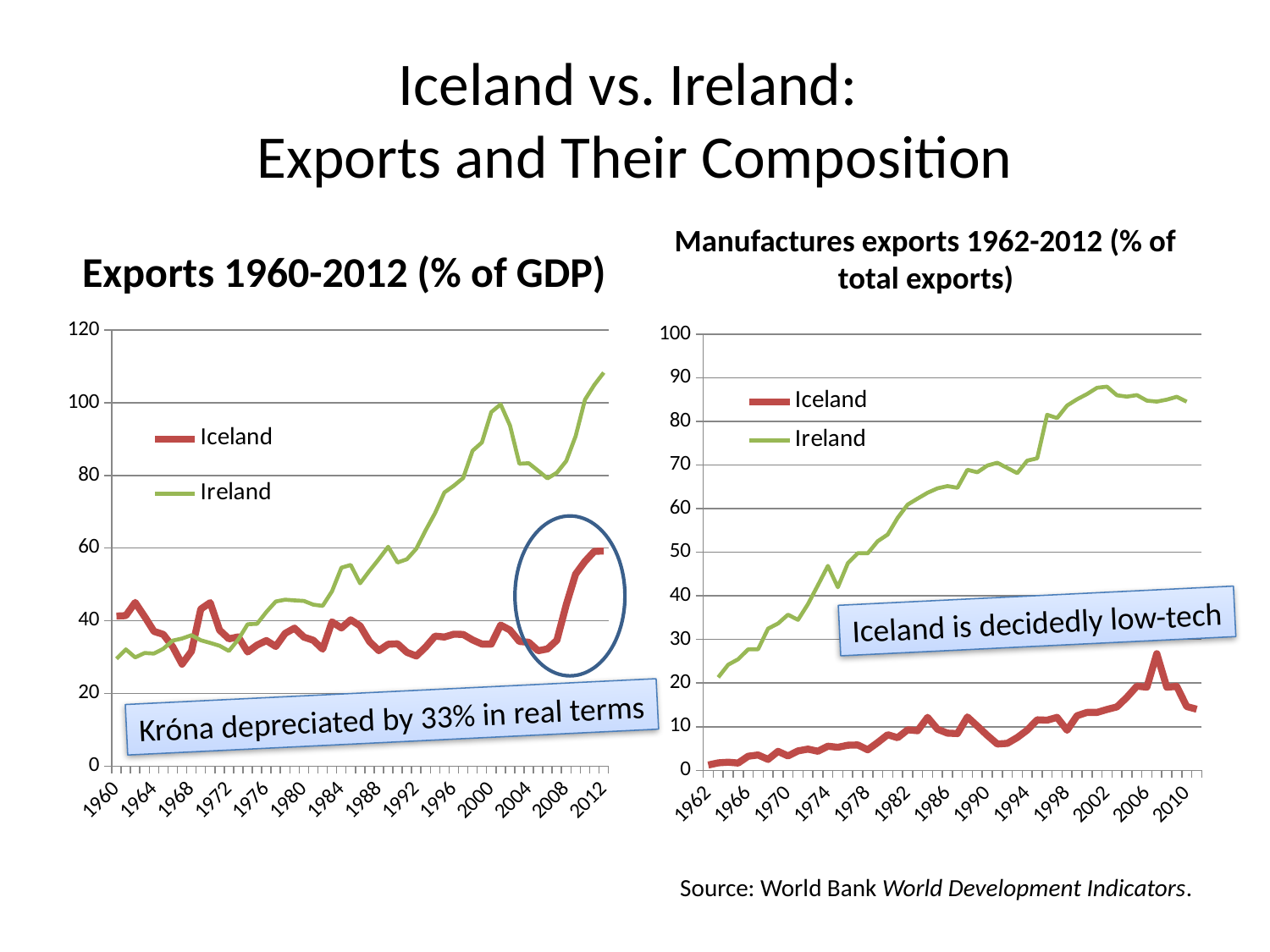
In the left chart 'Exports 1960-2012 (% of GDP)', which series is drawn in red? Iceland In the right chart 'Manufactures exports 1962-2012 (% of total exports)', is the value for Iceland in 1962 greater or less than 10? less In the left chart 'Exports 1960-2012 (% of GDP)', which series has the larger value in 1960, Iceland or Ireland? Iceland In the left chart 'Exports 1960-2012 (% of GDP)', is the value for Ireland in 2012 greater or less than 100? greater In the left chart 'Exports 1960-2012 (% of GDP)', which series has the larger value in 2012, Iceland or Ireland? Ireland In the right chart 'Manufactures exports 1962-2012 (% of total exports)', is the value for Ireland in 2002 greater or less than 80? greater What type of chart is the left chart titled 'Exports 1960-2012 (% of GDP)'? line chart In the right chart 'Manufactures exports 1962-2012 (% of total exports)', which series has the larger value in 2010, Iceland or Ireland? Ireland In the right chart 'Manufactures exports 1962-2012 (% of total exports)', does the Ireland series generally rise or fall from 1962 to 2012? rise How many series does the legend of the right chart, 'Manufactures exports 1962-2012 (% of total exports)', list? 2 What is the title of the right chart on the slide? Manufactures exports 1962-2012 (% of total exports)